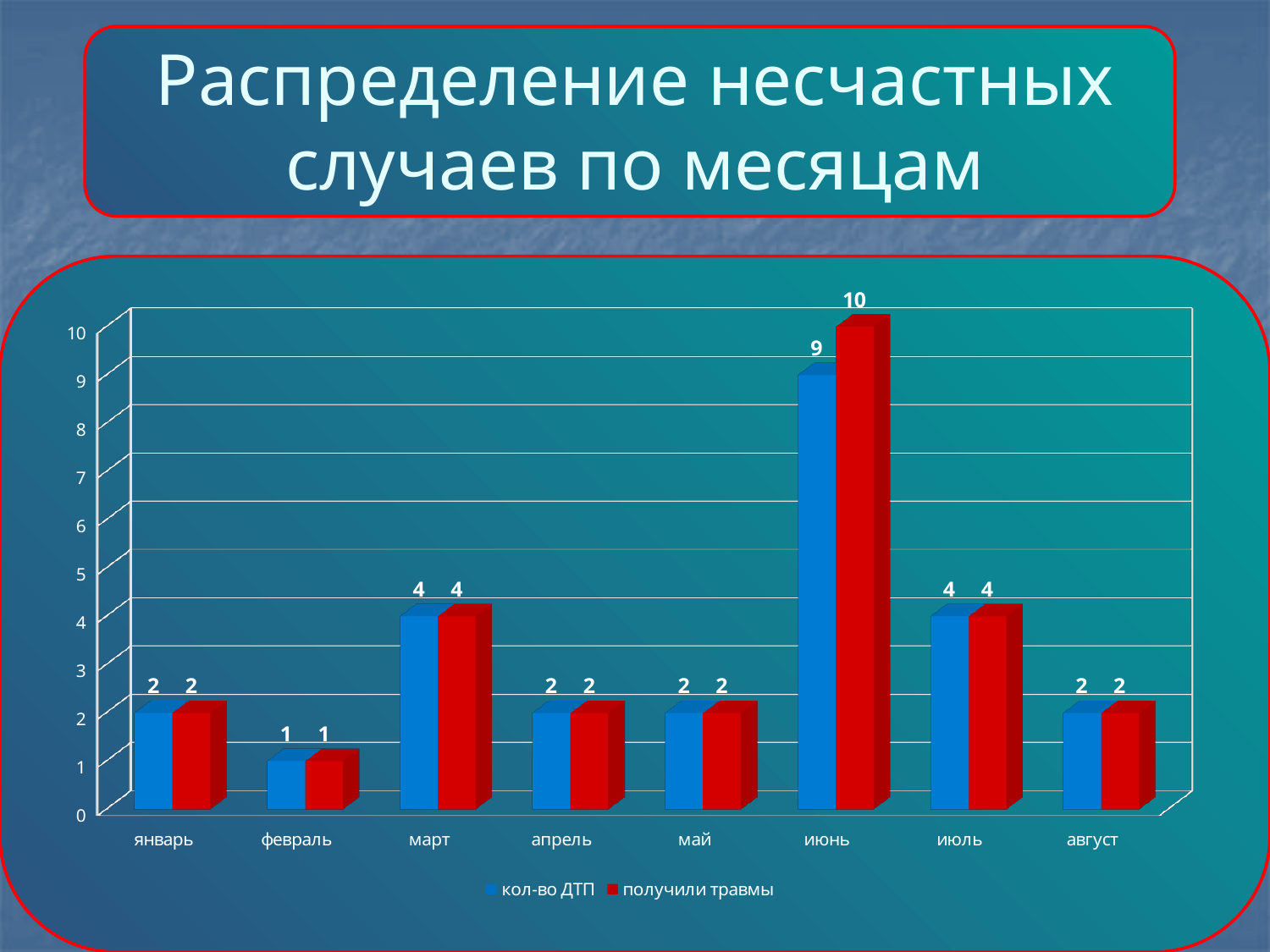
Which month has the lowest value for кол-во ДТП? февраль What colour are the bars for получили травмы? red What is the value of кол-во ДТП for февраль? 1 How many series does the legend list? 2 How many months are shown on the x axis? 8 What is the value of кол-во ДТП for июнь? 9 What is the value of получили травмы for июнь? 10 What is the difference between кол-во ДТП for июнь and кол-во ДТП for июль? 5 What kind of chart is shown on the slide? bar chart Which is larger: кол-во ДТП for март or кол-во ДТП for апрель? март Which month has the highest value for получили травмы? июнь What is the difference between получили травмы and кол-во ДТП for июнь? 1